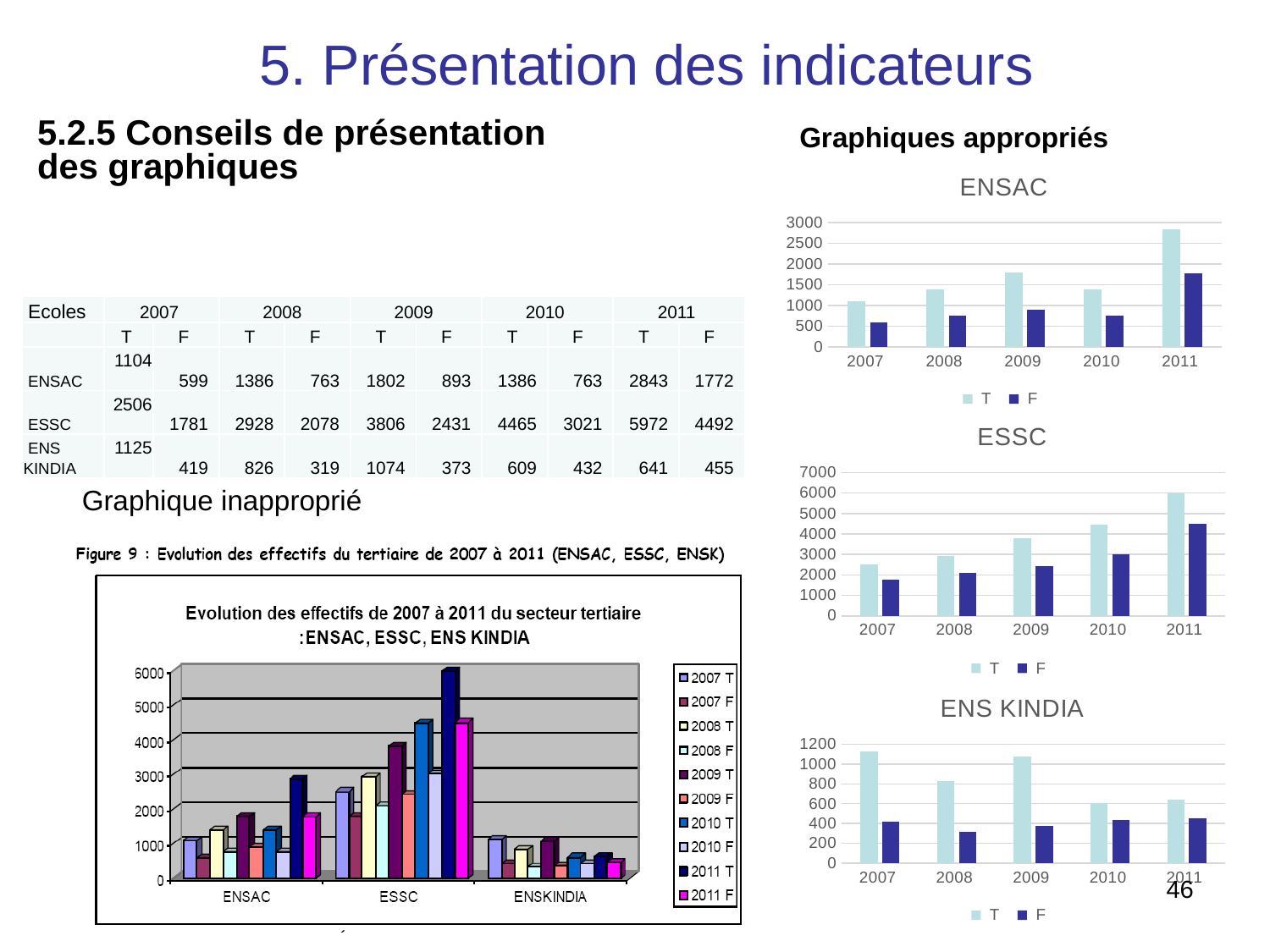
In the ESSC chart, which year has the lowest value for F? 2007 What kind of chart is the ESSC chart? bar chart In the ENS KINDIA chart, which is larger: T in 2007 or T in 2010? T in 2007 How many series does the legend of the ENSAC chart list? 2 How many series does the legend of the bottom-left chart (Evolution des effectifs de 2007 à 2011 du secteur tertiaire) list? 10 In the ENSAC chart, which year has the highest value for T? 2011 In the ENSAC chart, which is larger: T in 2009 or T in 2010? T in 2009 In the ESSC chart, is the value for F in 2007 greater or less than 2000? less In the ESSC chart, do the values for T rise or fall from 2007 to 2011? rise How many years are shown on the x axis of the ENS KINDIA chart? 5 In the ENSAC chart, is the value for T in 2011 greater or less than 2500? greater In the ENS KINDIA chart, is the value for F in 2008 greater or less than 400? less